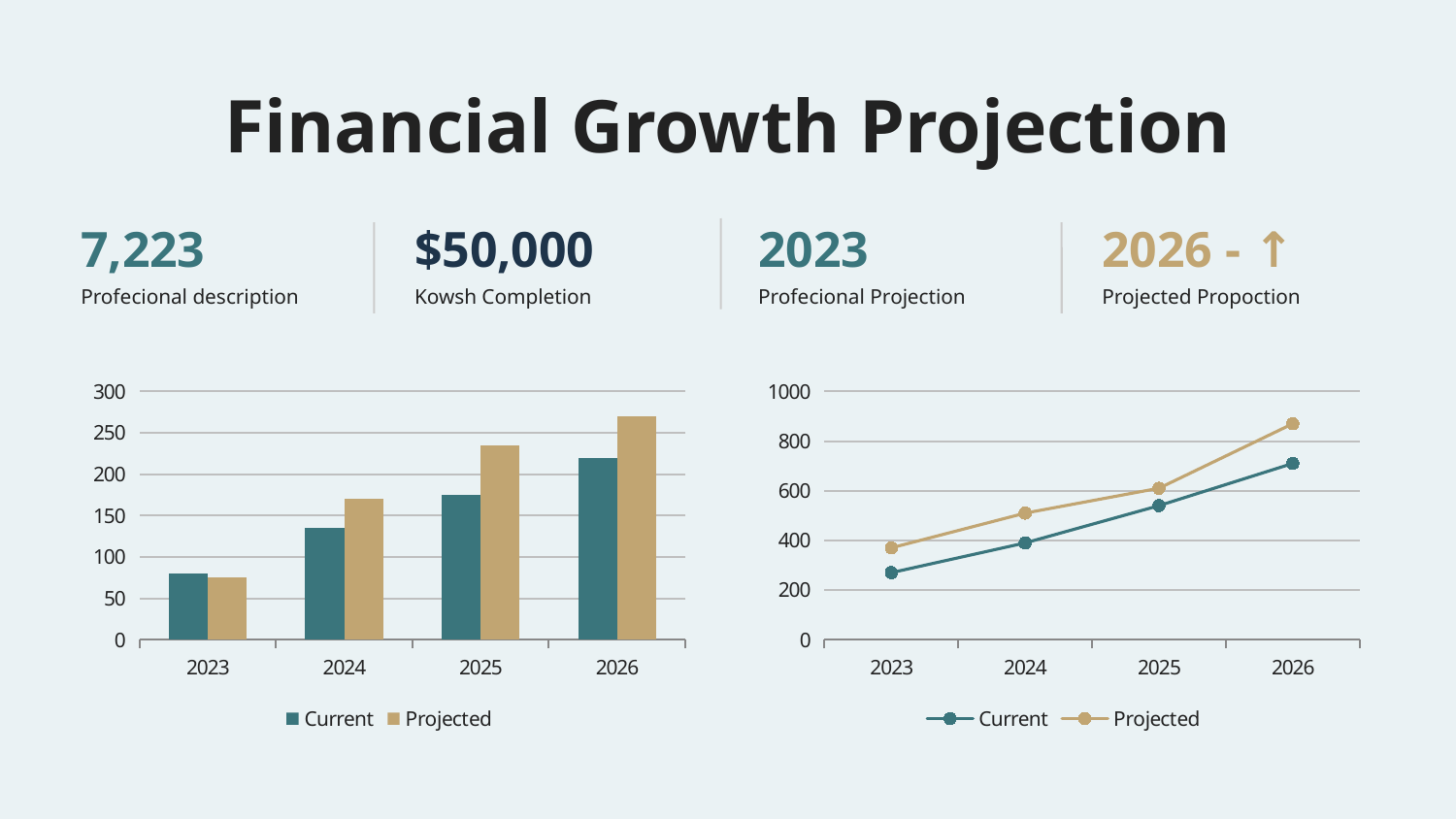
In the left bar chart, how many series does the legend list? 2 In the left bar chart, is the Current value for 2024 greater or less than 150? less In the right line chart, do the Current values rise or fall from 2023 to 2026? rise In the left bar chart, which is larger for 2025: Current or Projected? Projected In the right line chart, which series is shown in gold? Projected In the right line chart, is the Projected value for 2026 greater or less than 800? greater What kind of chart is the chart on the left of the slide? bar chart In the left bar chart, which year has the lowest Current bar? 2023 In the left bar chart, how many years are shown on the x axis? 4 What kind of chart is the chart on the right of the slide? line chart In the left bar chart, is the Projected value for 2026 greater or less than 250? greater In the left bar chart, which year has the highest Projected bar? 2026